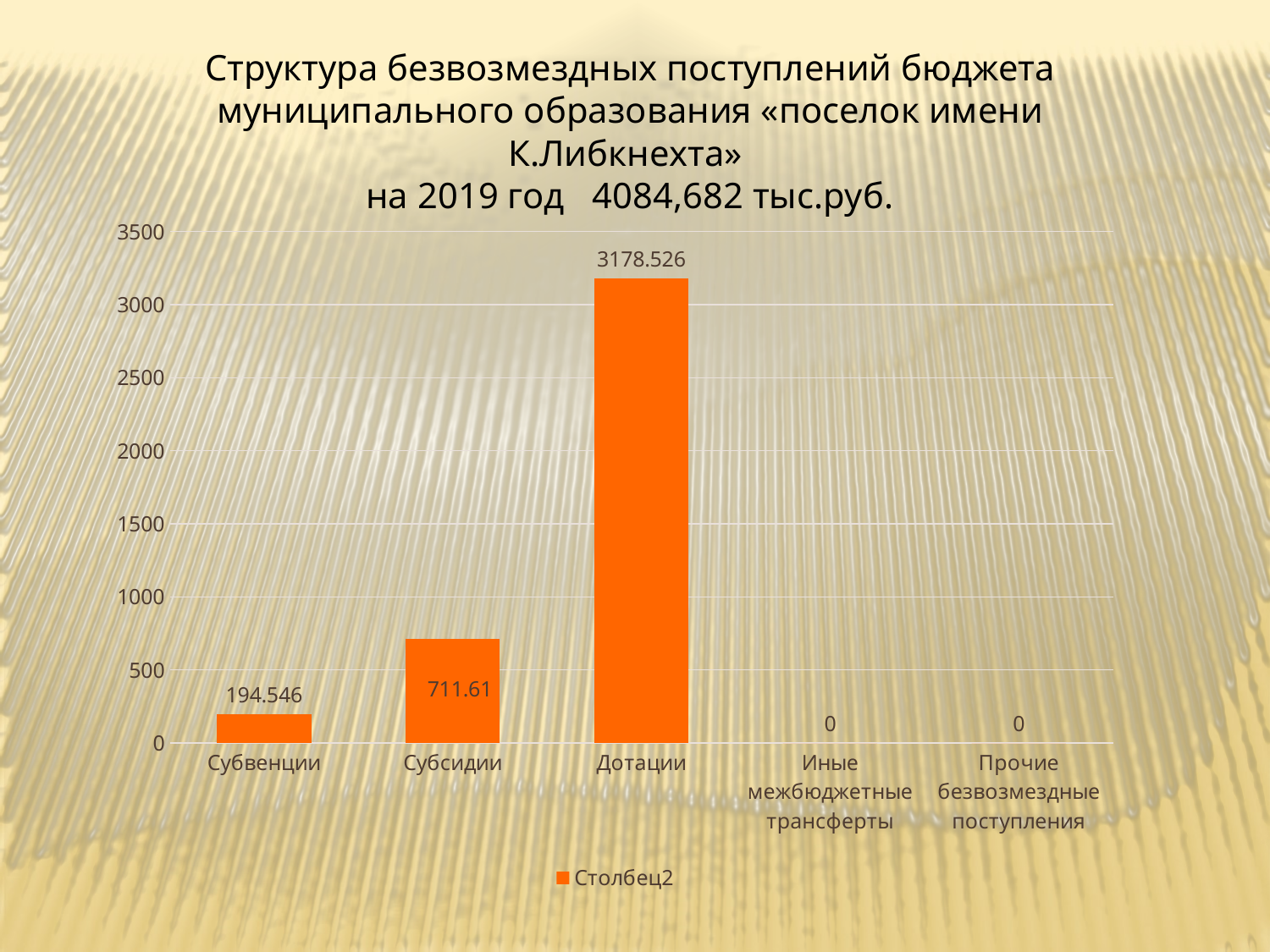
How many categories are shown on the x axis? 5 Is the value for Дотации greater or less than 3000? greater What is the value for Субсидии? 711.61 What kind of chart is shown on the slide? bar chart Which is larger, the value for Субсидии or the value for Субвенции? Субсидии What is the difference between the values for Субсидии and Субвенции? 517.064 What is the difference between the values for Дотации and Субсидии? 2466.916 What is the value for Иные межбюджетные трансферты? 0 Which category has the highest value? Дотации What is the value for Субвенции? 194.546 What series name does the legend show? Столбец2 What is the value for Дотации? 3178.526